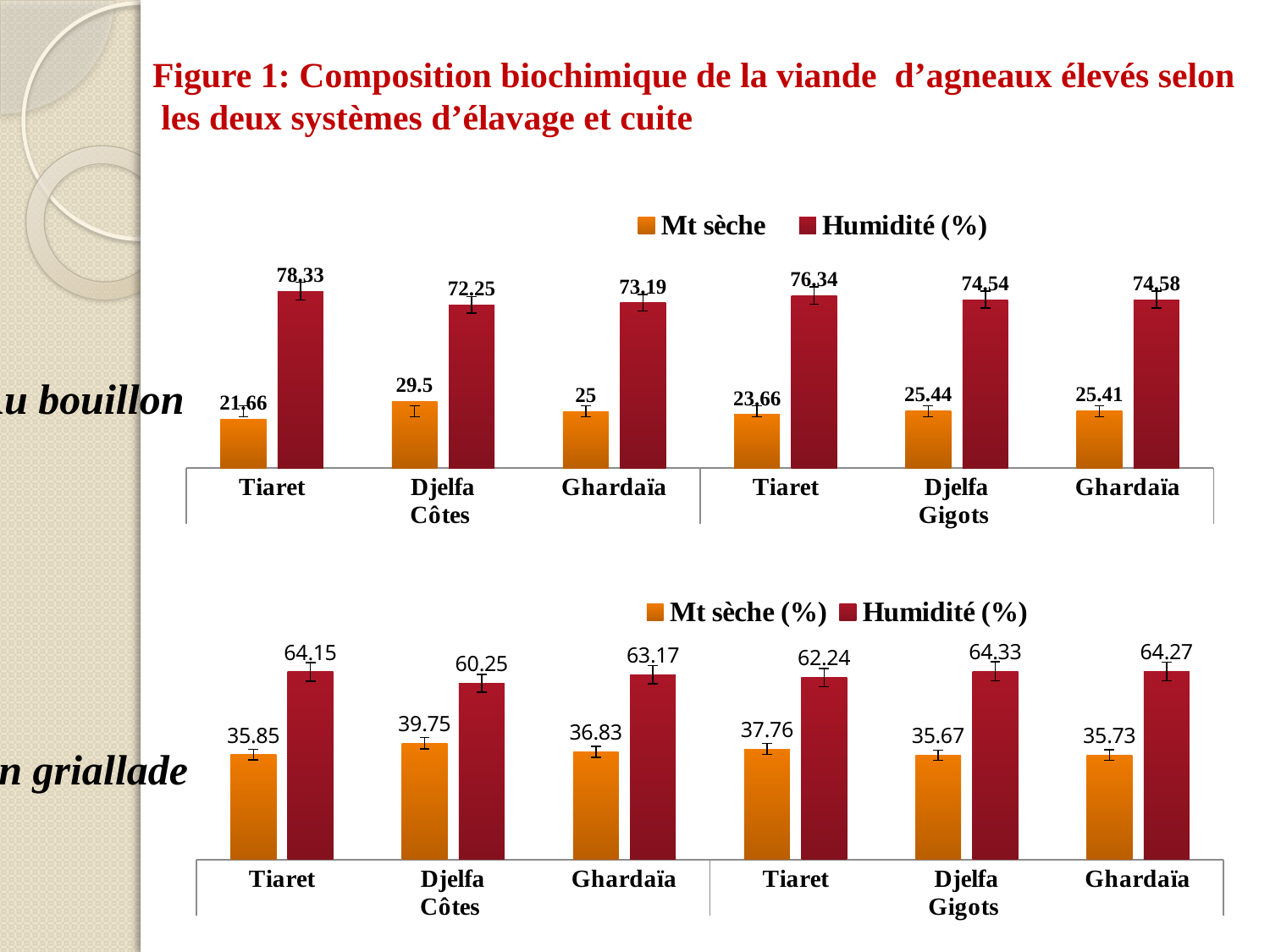
In the bottom chart, what is the Humidité (%) value for Ghardaïa in the Gigots group? 64.27 In the bottom chart, which category has the lowest Humidité (%) value? Djelfa (Côtes) How many series does the legend of the top chart list? 2 In the top chart, what is the Mt sèche value for Djelfa in the Gigots group? 25.44 In the top chart, which category has the lowest Mt sèche value? Tiaret (Côtes) In the bottom chart, what is the difference between the Humidité (%) values for Djelfa in the Gigots group and Djelfa in the Côtes group? 4.08 In the top chart, what is the difference between the Humidité (%) values for Tiaret and Djelfa in the Côtes group? 6.08 In the bottom chart, what is the Mt sèche (%) value for Djelfa in the Côtes group? 39.75 In the top chart, what is the Humidité (%) value for Tiaret in the Côtes group? 78.33 In the bottom chart, which is larger: the Mt sèche (%) value for Tiaret in the Côtes group or for Tiaret in the Gigots group? Tiaret (Gigots) In the top chart, which category has the highest Humidité (%) value? Tiaret (Côtes) What type of chart is the bottom chart? Bar chart